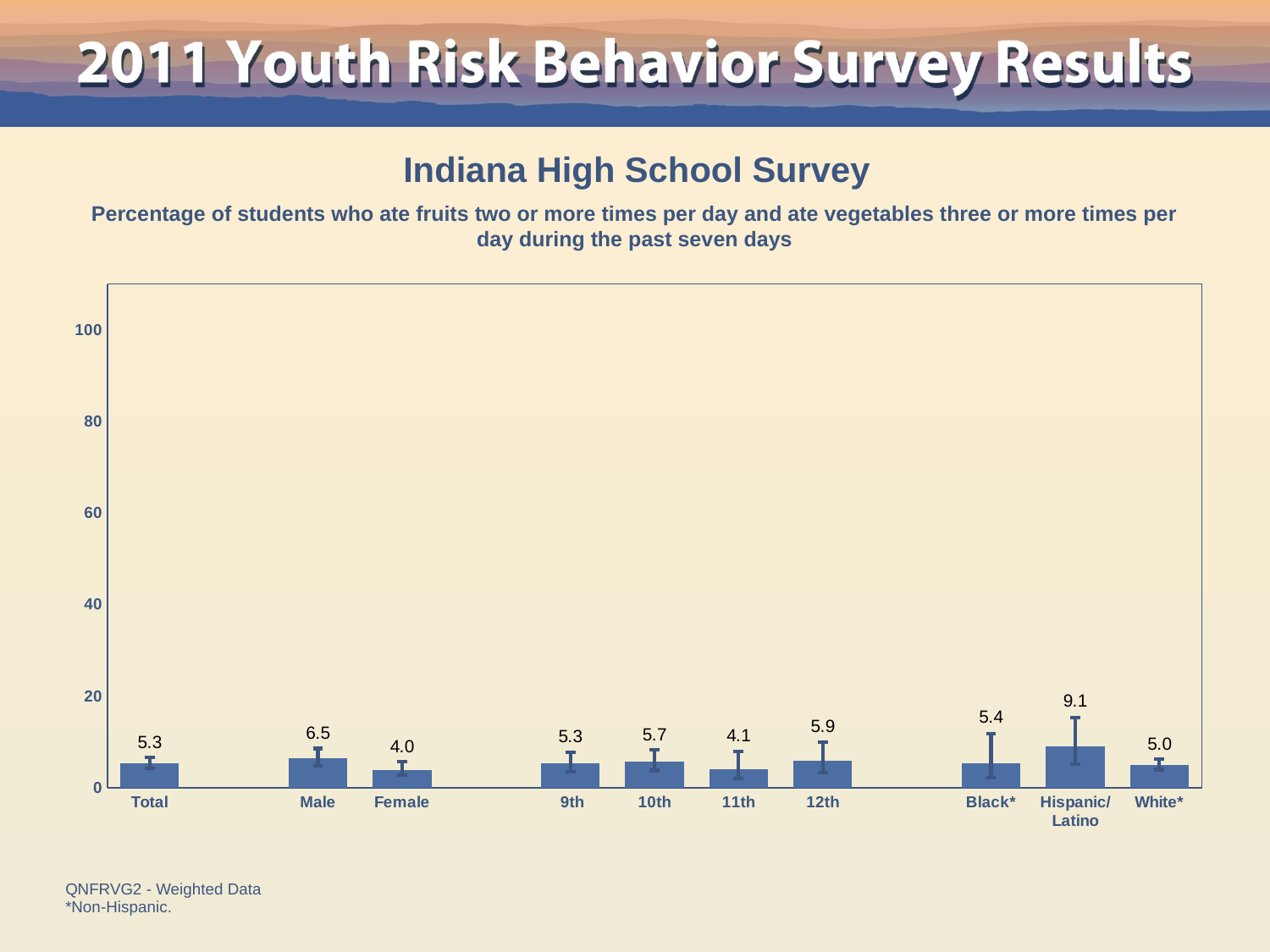
Which is larger, the value for 10th grade or the value for 12th grade? 12th Is the value for Hispanic/Latino greater or less than 20? less What is the difference between the Hispanic/Latino and White* values? 4.1 What is the value for Male? 6.5 Which category has the highest value? Hispanic/Latino What is the title of the chart? Indiana High School Survey What is the value for Hispanic/Latino? 9.1 What is the difference between the Male and Female values? 2.5 What kind of chart is this? bar chart Which category has the lowest value? Female What is the value for 11th grade? 4.1 How many categories are shown on the x axis? 10